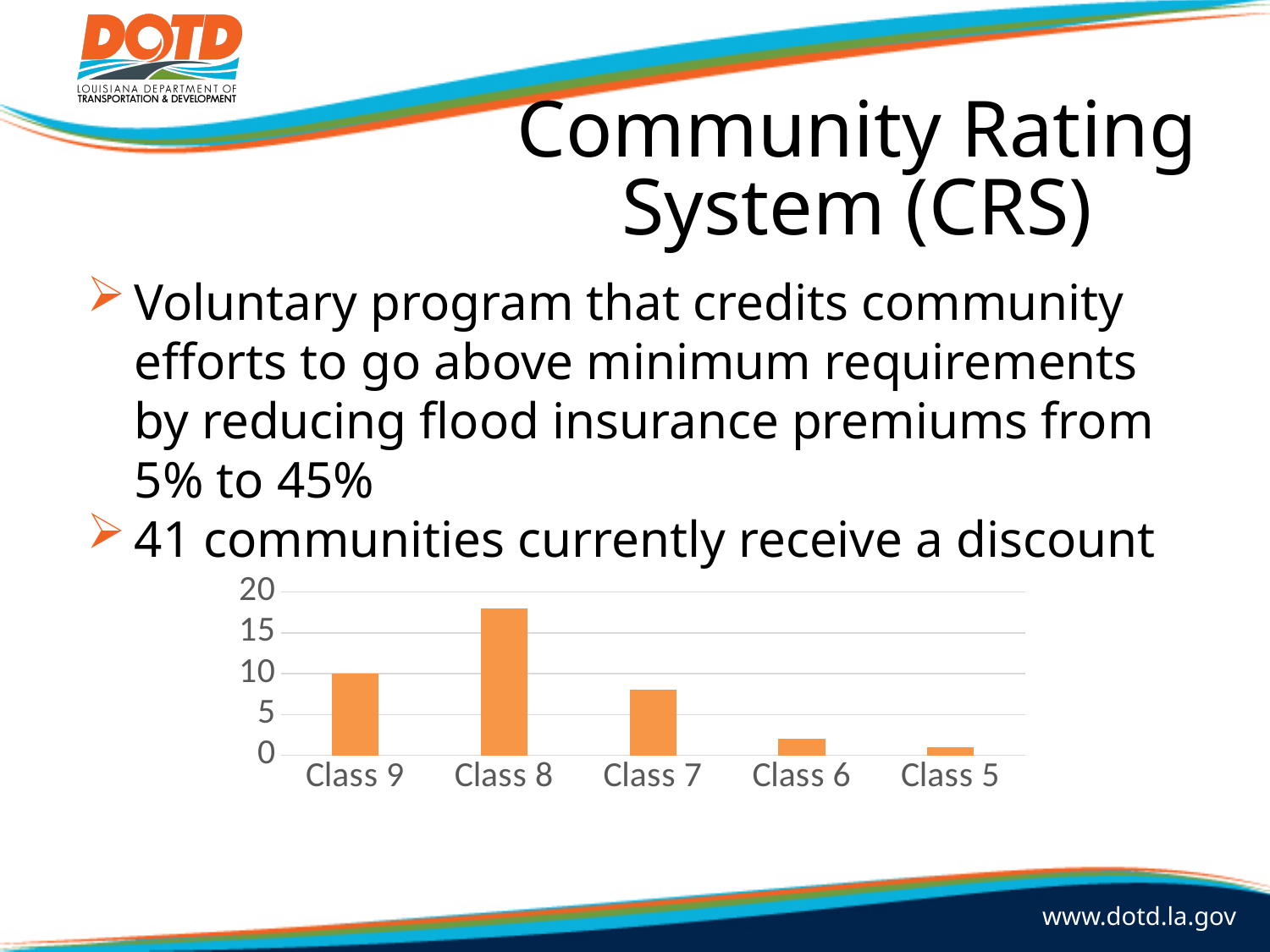
What kind of chart is shown on the slide? bar chart What is the value for Class 9 in the chart? 10 Which is larger, the value for Class 9 or the value for Class 7? Class 9 How many classes are shown on the x axis of the chart? 5 From Class 8 to Class 5, do the bar values rise or fall along the x axis? fall Is the value for Class 6 greater or less than 5? less Is the value for Class 7 greater or less than 10? less Which class has the highest bar in the chart? Class 8 Which class has the lowest bar in the chart? Class 5 Is the value for Class 7 greater or less than 5? greater What colour are the bars in the chart? orange